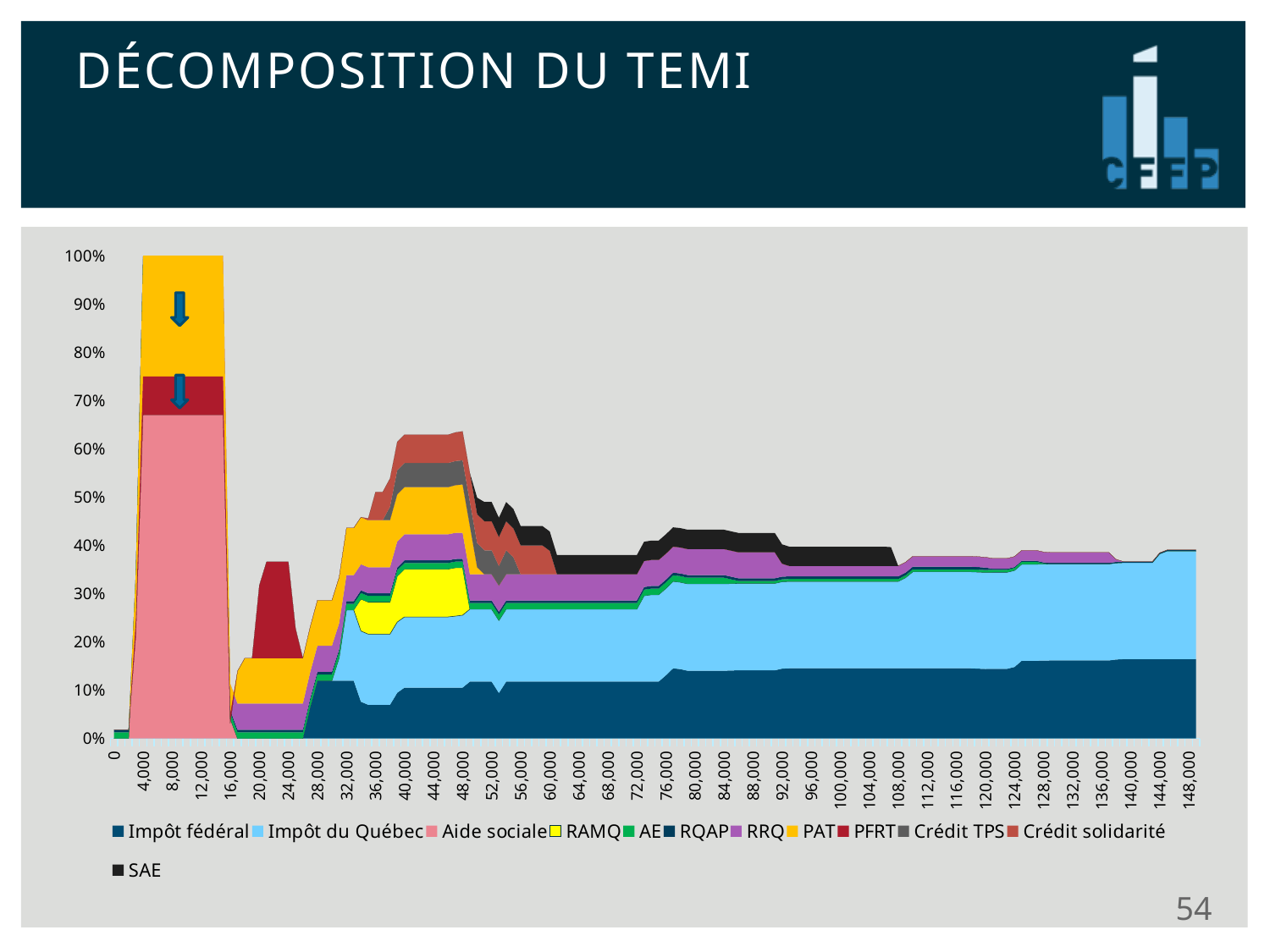
Does the total stacked value rise or fall between 44,000 and 64,000? fall Is the total stacked value at 44,000 greater or less than 60%? greater Is the total stacked value at 148,000 greater or less than 50%? less What is the title of the slide containing the chart? DÉCOMPOSITION DU TEMI Which series is plotted at the bottom of the stack (dark blue)? Impôt fédéral Does the total stacked value rise or fall between 28,000 and 44,000? rise Is the total stacked value at 8,000 greater or less than 90%? greater What kind of chart is shown on the slide? Stacked area chart What is the highest value shown on the y axis? 100% How many series does the legend list? 12